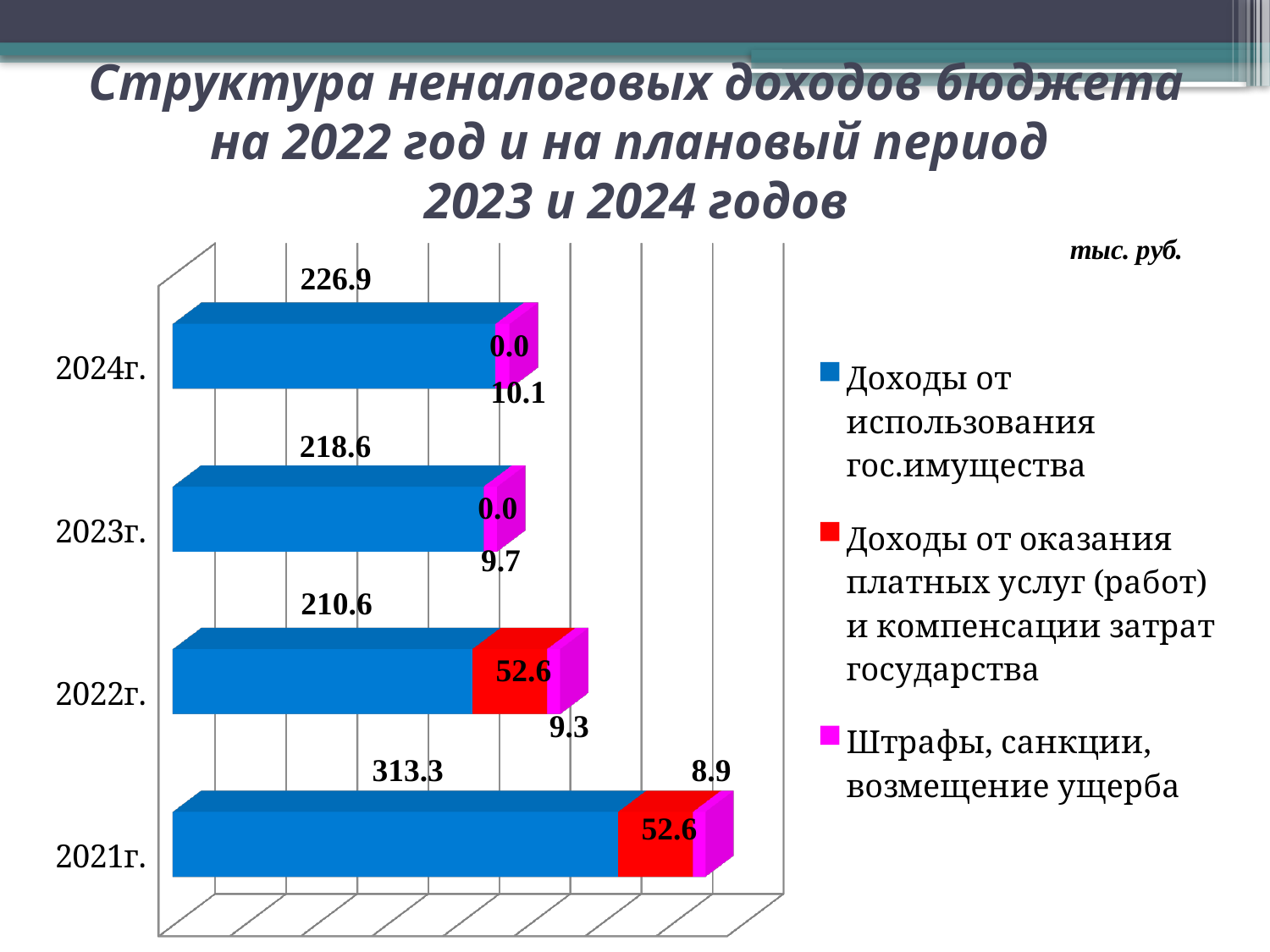
What type of chart is shown on the slide? Stacked bar chart What is the value of 'Доходы от оказания платных услуг (работ) и компенсации затрат государства' for 2023г.? 0.0 What is the value of 'Доходы от использования гос.имущества' for 2021г.? 313.3 Which year has the highest value for 'Доходы от использования гос.имущества'? 2021г. What is the value of 'Штрафы, санкции, возмещение ущерба' for 2024г.? 10.1 Which year has the lowest value for 'Штрафы, санкции, возмещение ущерба'? 2021г. How many series does the legend list? 3 How many year categories are shown on the chart? 4 What is the difference between the 'Доходы от использования гос.имущества' values for 2021г. and 2022г.? 102.7 Which is larger: 'Доходы от использования гос.имущества' for 2023г. or for 2024г.? 2024г. What is the total of the stacked bar for 2022г.? 272.5 What unit is indicated in the top right corner of the chart? тыс. руб.